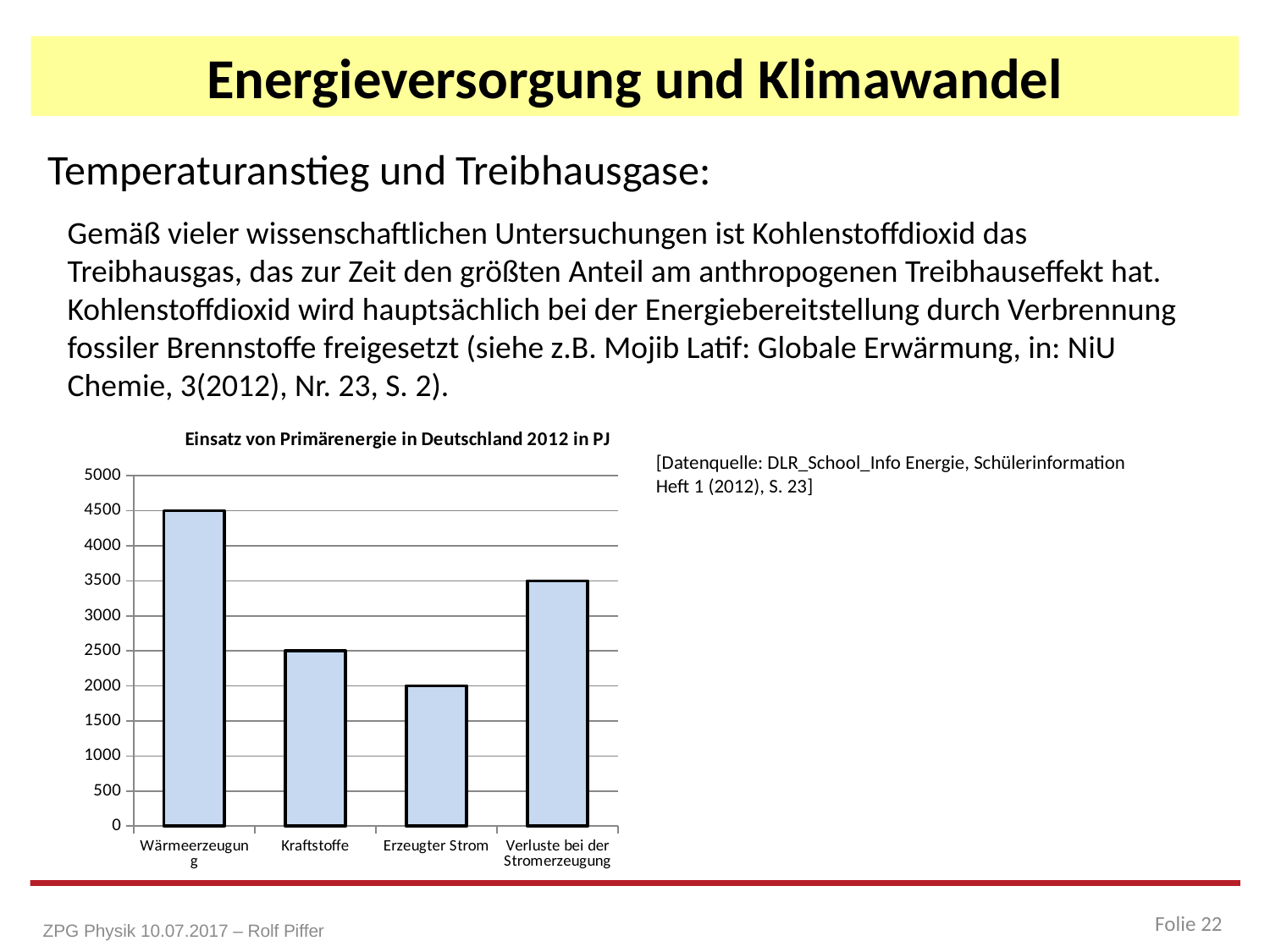
What kind of chart is shown on the slide? bar chart What is the value for Verluste bei der Stromerzeugung? 3500 Is the value for Erzeugter Strom greater or less than 3000? less Which category has the highest value? Wärmeerzeugung What is the value for Wärmeerzeugung? 4500 What is the value for Erzeugter Strom? 2000 What is the difference between the values for Wärmeerzeugung and Erzeugter Strom? 2500 What is the title of the chart? Einsatz von Primärenergie in Deutschland 2012 in PJ Which category has the lowest value? Erzeugter Strom How many categories are shown in the chart? 4 Which is larger, the value for Kraftstoffe or the value for Verluste bei der Stromerzeugung? Verluste bei der Stromerzeugung What is the value for Kraftstoffe? 2500